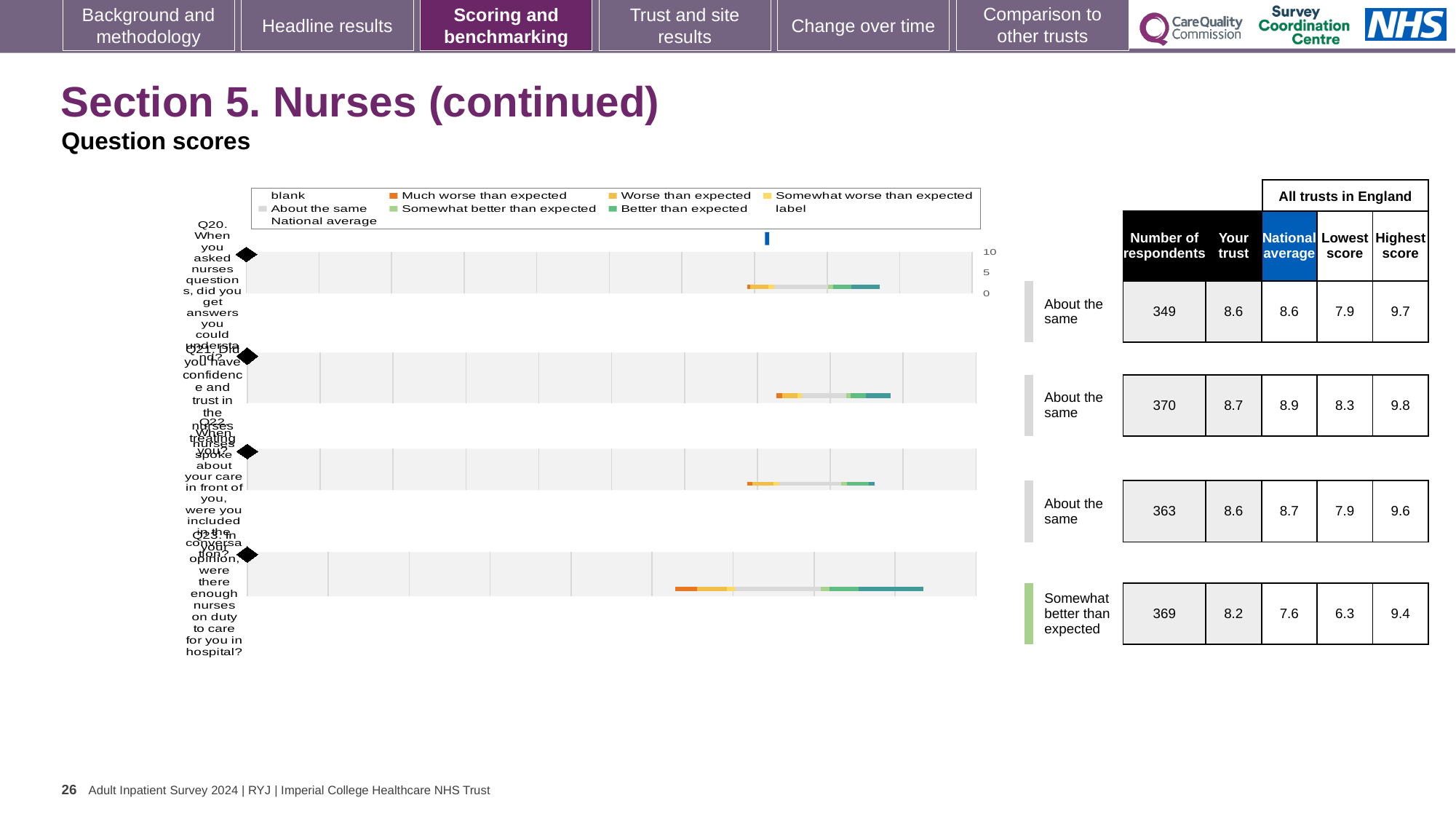
According to the table, what is the highest score across all trusts in England for Q22? 9.6 Which legend entry is shown in dark orange? Much worse than expected According to the table, what is the national average for Q23? 7.6 What kind of chart is shown on the slide? bar chart For Q21, which is larger: the 'Your trust' score or the national average? National average What is the difference between the 'Your trust' score and the national average for Q23? 0.6 Which question has the highest 'Your trust' score in the table? Q21 How many survey questions (bars) are plotted in the chart? 4 Which question has the lowest 'Your trust' score in the table? Q23 What is the highest value shown on the chart's axis? 10 According to the table, how many respondents answered Q21? 370 According to the table, what is the 'Your trust' score for Q20? 8.6